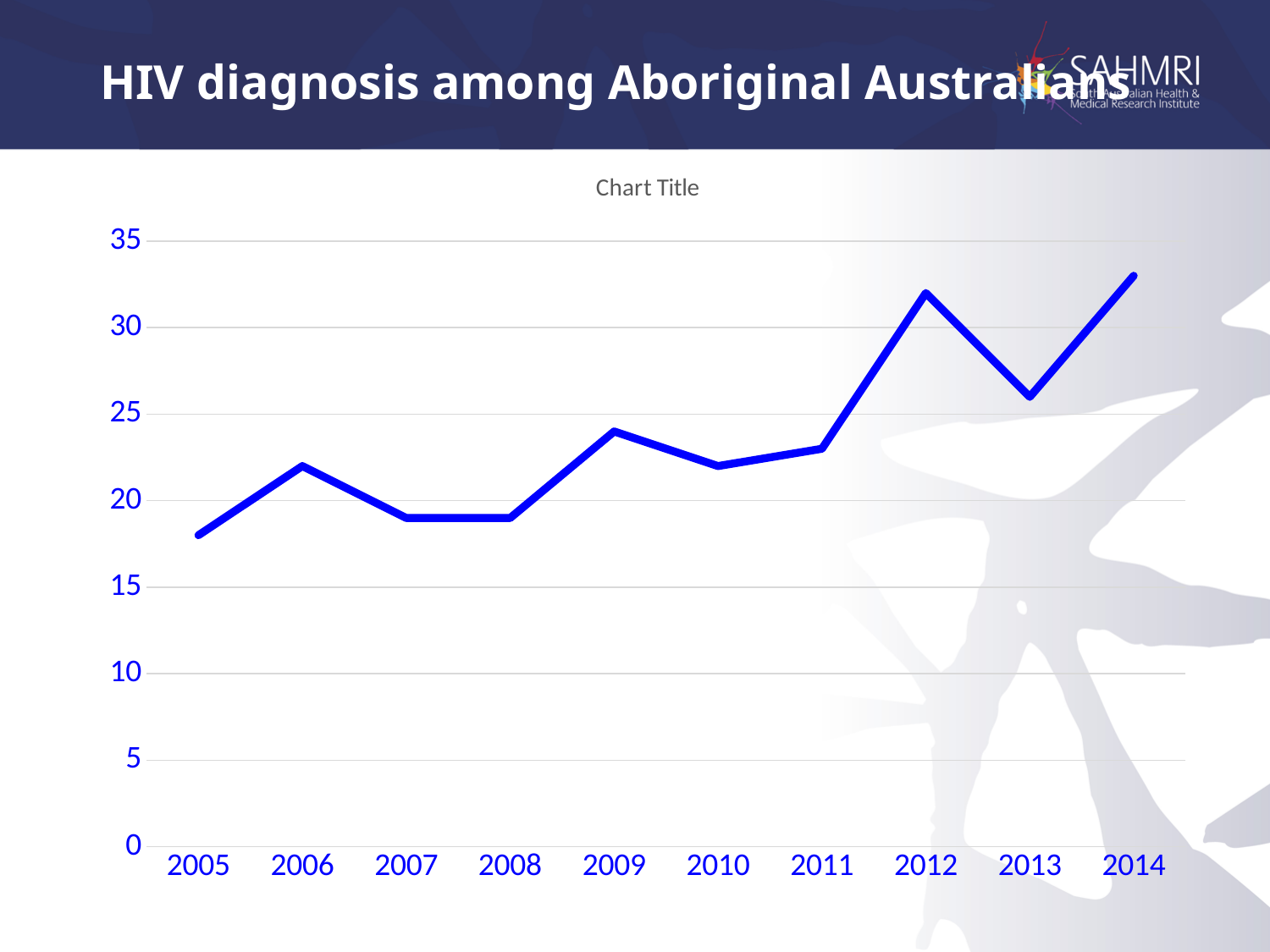
Is the value for 2007 greater or less than 20? less Is the value for 2014 greater or less than 30? greater What title is printed above the chart area? Chart Title Is the value for 2005 greater or less than 20? less How many years are plotted along the x axis? 10 What kind of chart is shown on the slide? line chart Which year has the larger value, 2012 or 2013? 2012 Overall, do the values rise or fall from 2005 to 2014? rise Which year has the larger value, 2005 or 2014? 2014